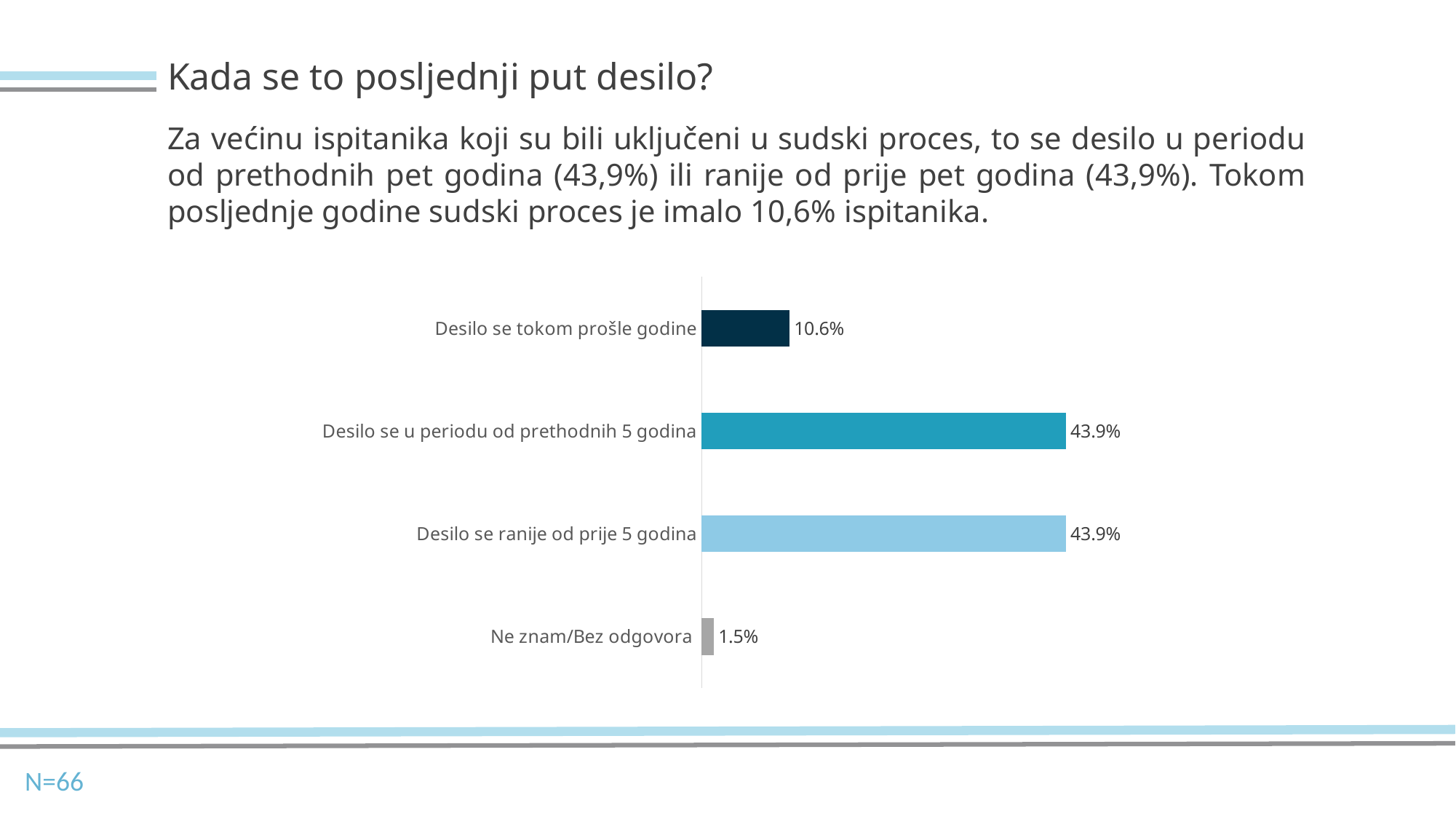
What is the value for "Desilo se u periodu od prethodnih 5 godina"? 43.9% Which is larger: the value for "Desilo se tokom prošle godine" or the value for "Ne znam/Bez odgovora"? Desilo se tokom prošle godine Which is larger: the value for "Desilo se ranije od prije 5 godina" or the value for "Desilo se tokom prošle godine"? Desilo se ranije od prije 5 godina What is the difference between the values for "Desilo se tokom prošle godine" and "Ne znam/Bez odgovora"? 9.1% What is the value for "Desilo se ranije od prije 5 godina"? 43.9% What is the difference between the values for "Desilo se u periodu od prethodnih 5 godina" and "Desilo se tokom prošle godine"? 33.3% How many categories are shown in the chart? 4 What is the sample size (N) shown on the slide? N=66 What kind of chart is shown on the slide? Bar chart What is the value for "Desilo se tokom prošle godine"? 10.6% Which category has the lowest value? Ne znam/Bez odgovora What is the value for "Ne znam/Bez odgovora"? 1.5%